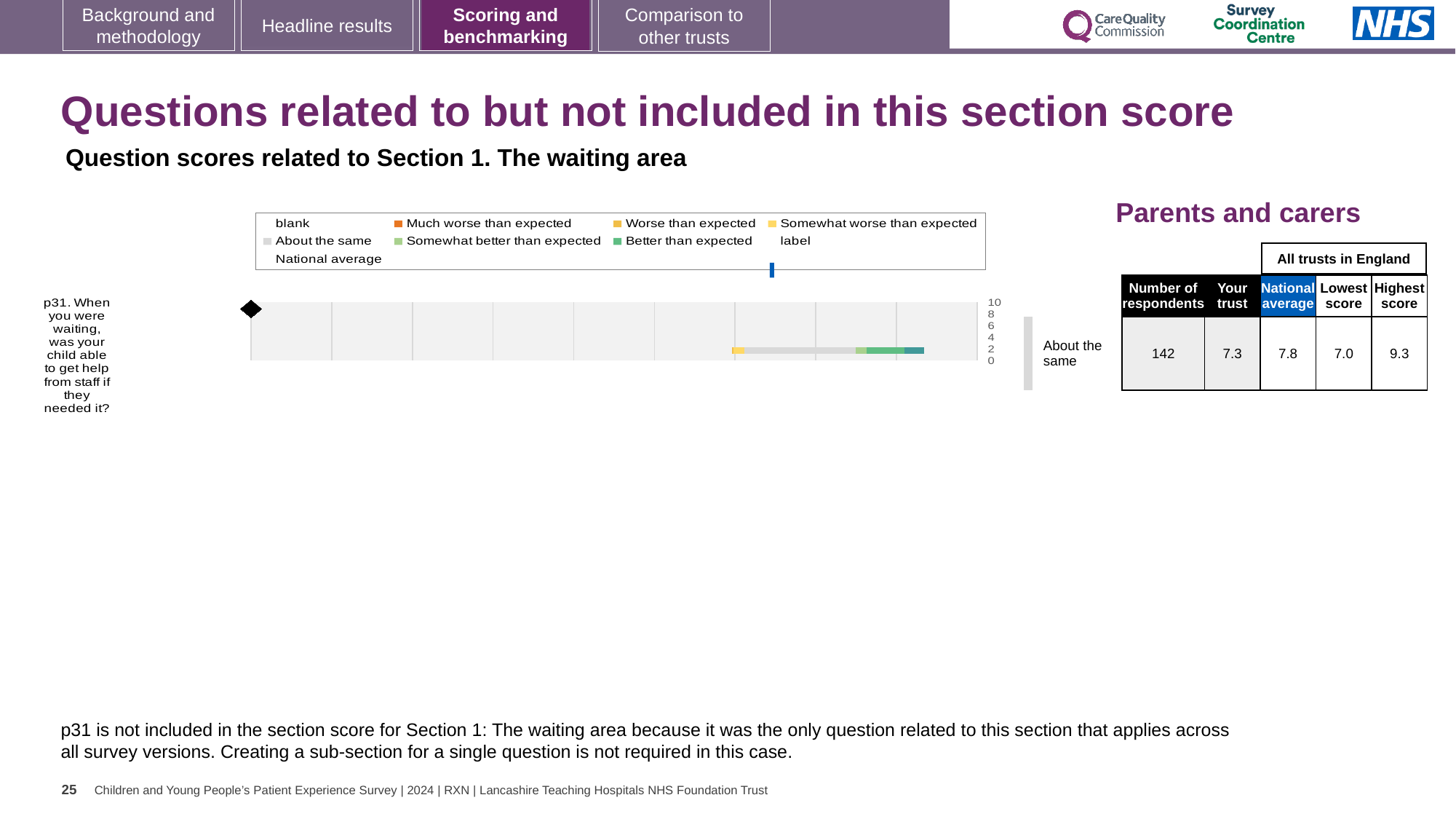
What is the difference between the highest score and the lowest score for p31? 2.3 How many entries does the chart legend list? 9 Which question is plotted in the chart? p31. When you were waiting, was your child able to get help from staff if they needed it? In the Parents and carers table, what is the 'Your trust' score for p31? 7.3 How many questions are plotted in the chart? 1 In the Parents and carers table, how many respondents answered p31? 142 What kind of chart is used to show the p31 question score? bar chart In the Parents and carers table, what is the highest score across all trusts in England for p31? 9.3 What benchmark category is shown to the right of the bar for p31? About the same In the Parents and carers table, what is the lowest score across all trusts in England for p31? 7.0 In the Parents and carers table, what is the national average score for p31? 7.8 Which is larger for p31, the 'Your trust' score or the national average? National average